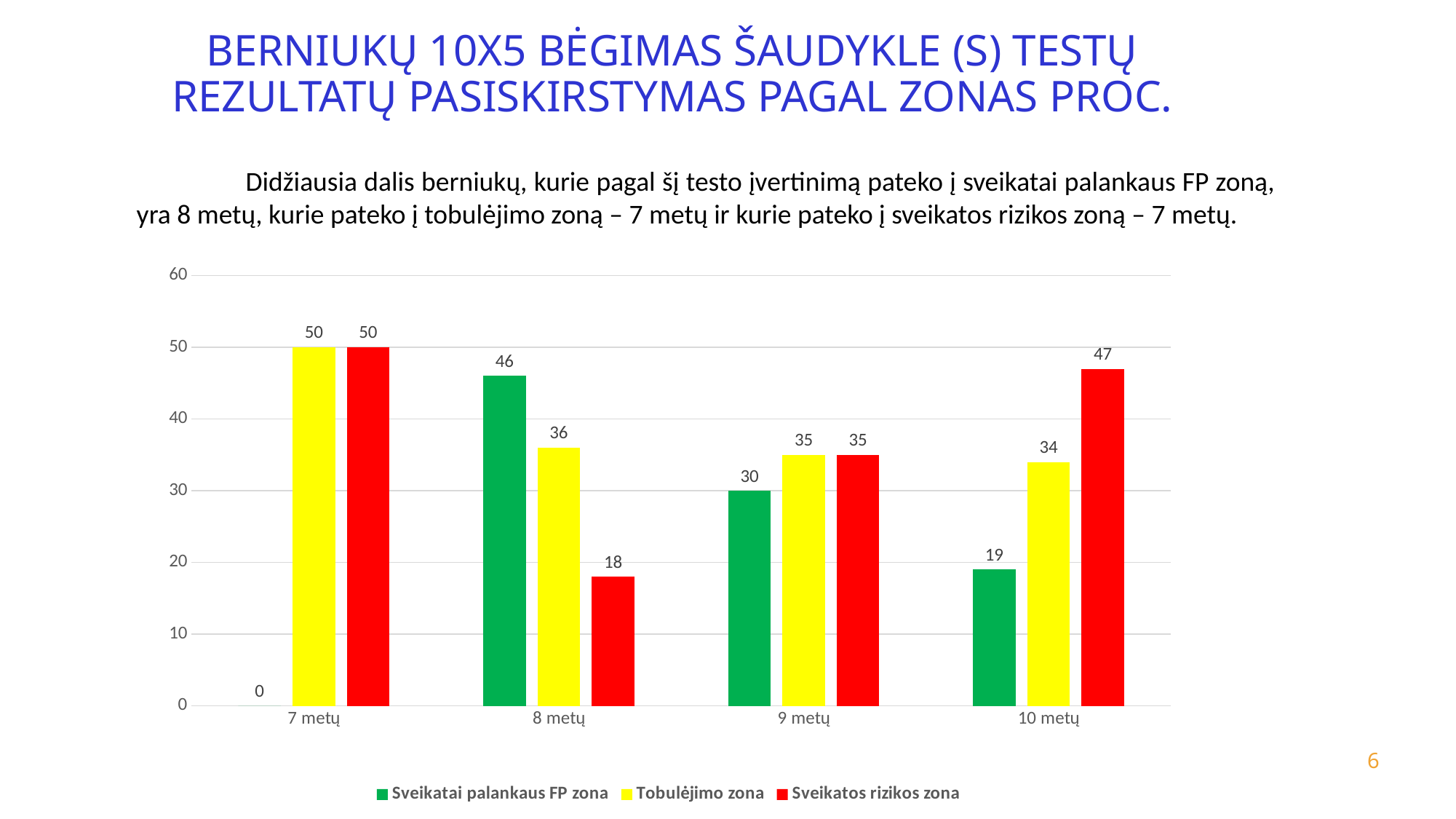
What is the value for Sveikatai palankaus FP zona at 8 metų? 46 What is the value for Sveikatos rizikos zona at 10 metų? 47 What is the difference between the Tobulėjimo zona value and the Sveikatos rizikos zona value at 8 metų? 18 How many age groups are shown on the x axis? 4 Which age group has the highest value for Sveikatai palankaus FP zona? 8 metų What is the value for Sveikatai palankaus FP zona at 7 metų? 0 Which colour represents Sveikatos rizikos zona in the legend? Red Which age group has the lowest value for Sveikatos rizikos zona? 8 metų What is the value for Tobulėjimo zona at 9 metų? 35 What kind of chart is shown on the slide? Bar chart Which is larger at 10 metų: Sveikatai palankaus FP zona or Tobulėjimo zona? Tobulėjimo zona How many series does the legend list? 3